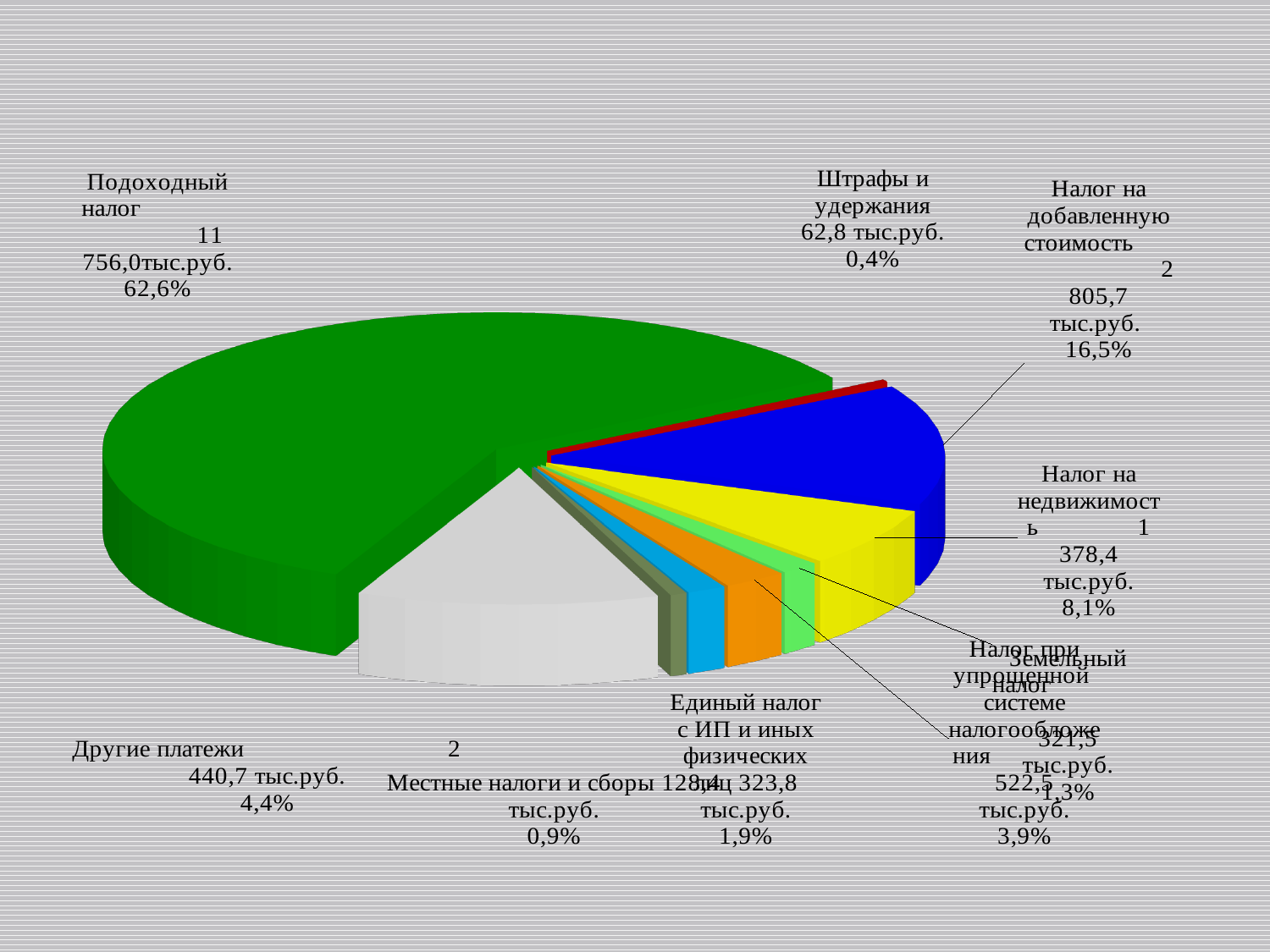
Which category has the largest slice of the pie? Подоходный налог What is the value shown for Налог на добавленную стоимость? 2 805,7 тыс.руб. How many categories (slices) does the pie chart have? 9 What share of the pie does Подоходный налог account for? 62,6% What is the value shown for Штрафы и удержания? 62,8 тыс.руб. Which is larger: Налог на добавленную стоимость or Налог на недвижимость? Налог на добавленную стоимость By how many percentage points does the share of Подоходный налог exceed that of Налог на добавленную стоимость? 46,1% What percentage is shown for Налог на недвижимость? 8,1% What colour is the largest slice of the pie? green Which category has the smallest share of the pie? Штрафы и удержания What kind of chart is shown on the slide? pie chart What percentage is shown for Другие платежи? 4,4%